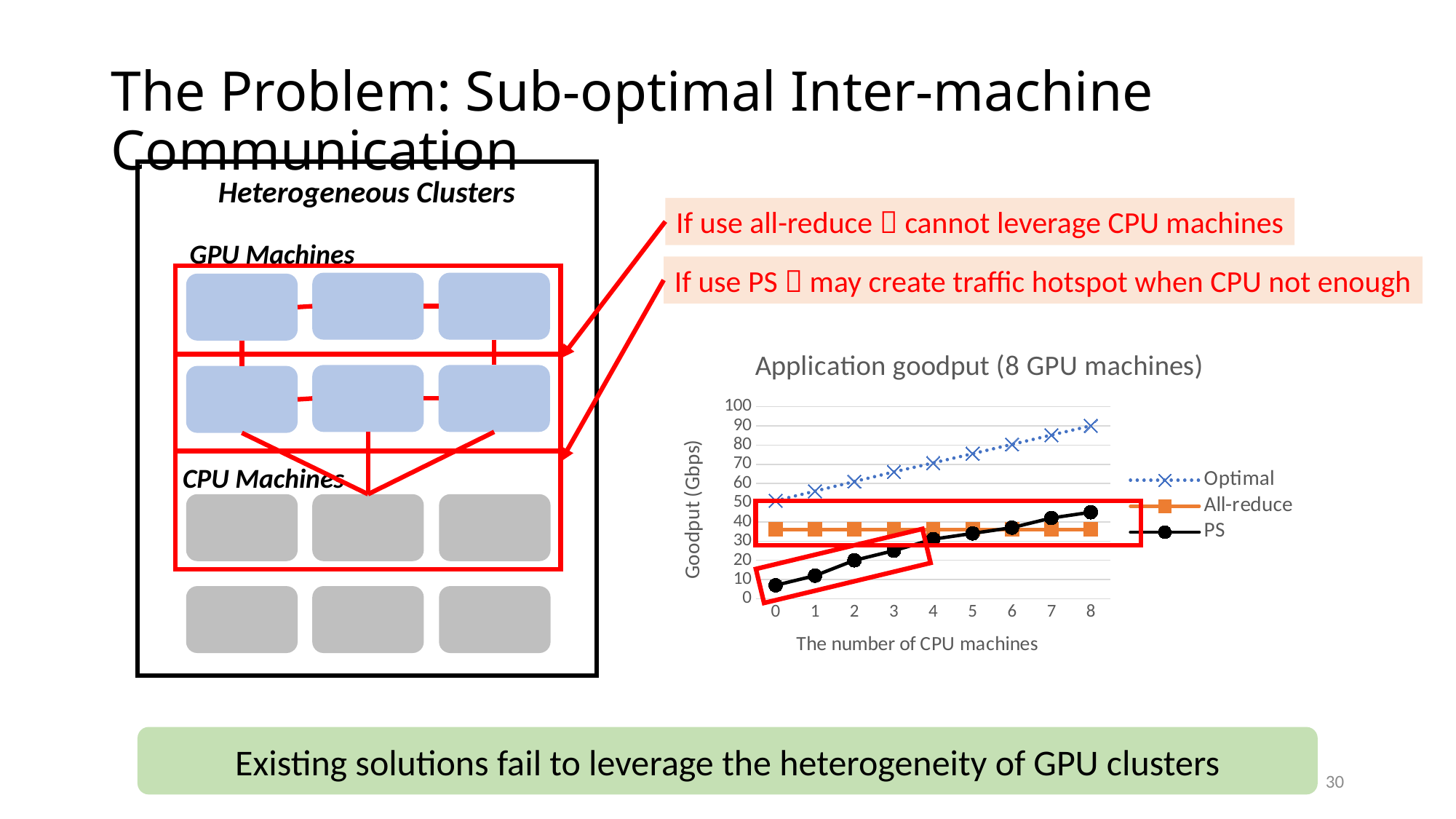
What is the title of the chart? Application goodput (8 GPU machines) At 0 CPU machines, which series has the higher goodput, Optimal or PS? Optimal What kind of chart is shown on the slide? line chart How does the All-reduce goodput change as the number of CPU machines increases from 0 to 8? it stays flat What are the legend entries of the chart? Optimal, All-reduce, PS How many series does the legend of the chart list? 3 Is the Optimal goodput at 8 CPU machines greater or less than 80? greater How many points along the x axis (number of CPU machines) are plotted for each series? 9 Is the All-reduce goodput at 4 CPU machines greater or less than 40? less At 8 CPU machines, which series has the highest goodput? Optimal Is the PS goodput at 0 CPU machines greater or less than 10? less How does the PS goodput change as the number of CPU machines increases from 0 to 8? it rises